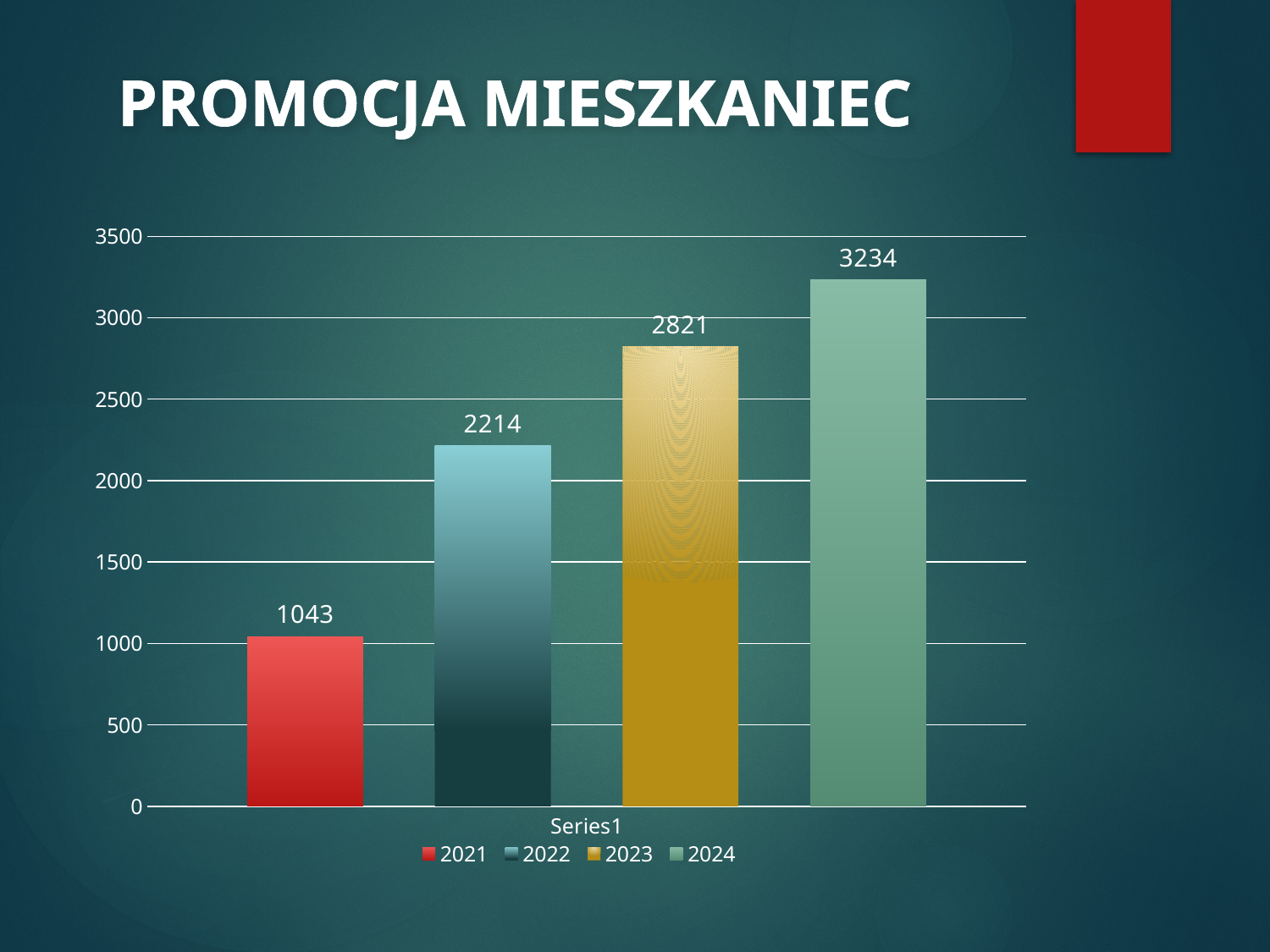
What is the difference between the values for 2024 and 2021? 2191 What is the value for 2024? 3234 Which is larger, the value for 2022 or the value for 2023? 2023 What is the value for 2021? 1043 What kind of chart is shown on the slide? bar chart Which year has the lowest value? 2021 What is the value for 2023? 2821 Which year has the highest value? 2024 Do the values rise or fall from 2021 to 2024? rise What is the difference between the values for 2023 and 2022? 607 What is the value for 2022? 2214 How many series does the legend list? 4